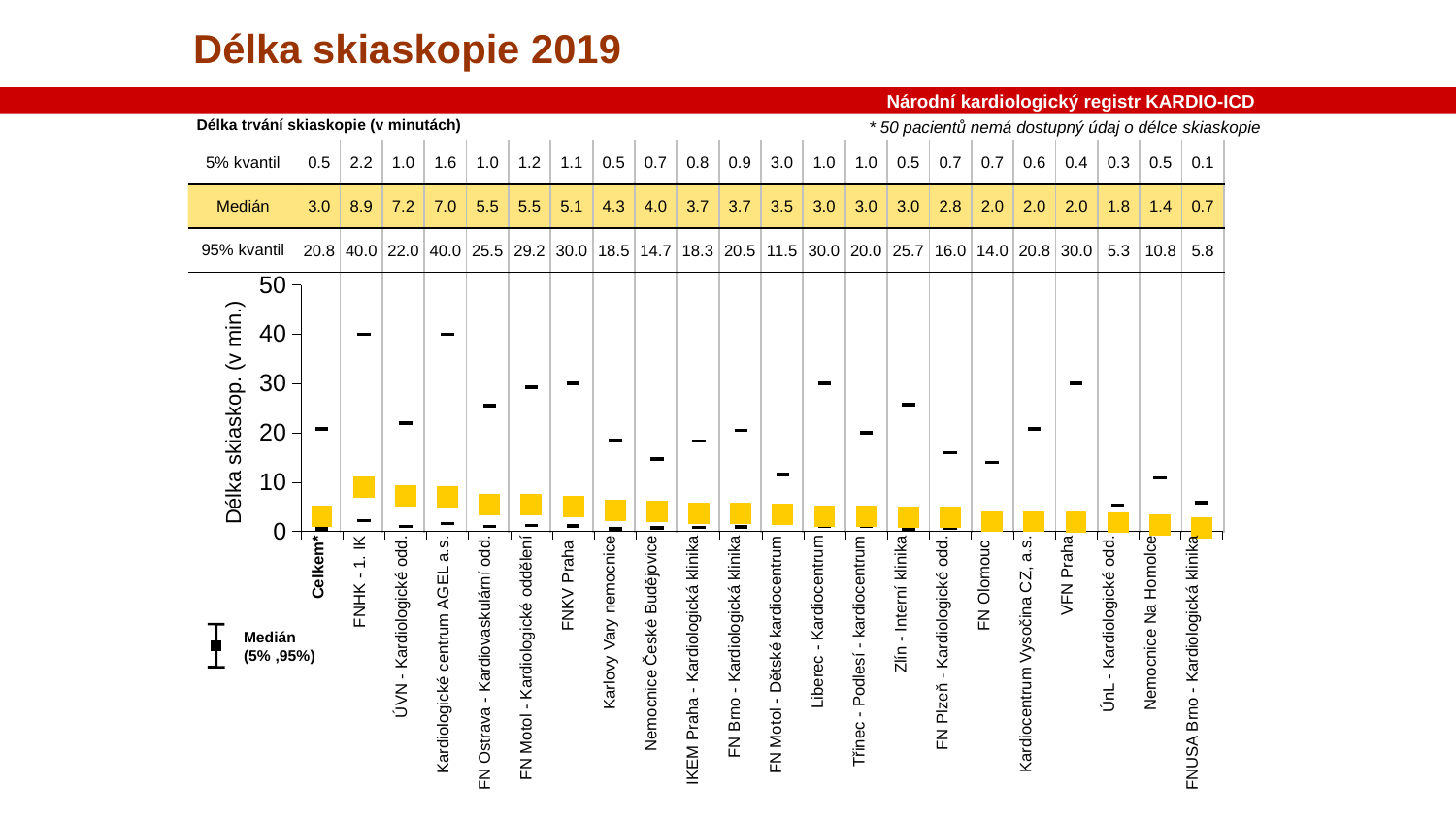
Which centre has the lowest median length of skiascopy? FNUSA Brno - Kardiologická klinika According to the footnote, how many patients have no available data on the length of skiascopy? 50 Which has the larger 95% kvantil value: Liberec - Kardiocentrum or Třinec - Podlesí - kardiocentrum? Liberec - Kardiocentrum How many centres (categories) are shown on the x axis of the chart? 22 Do the median values rise or fall moving from left to right along the x axis? fall What is the median (Medián) length of skiascopy for FNHK - 1. IK? 8.9 What is the 5% kvantil value for FN Motol - Dětské kardiocentrum? 3.0 What is the 95% kvantil value for FNKV Praha? 30.0 What is the median value for Celkem*? 3.0 Which centre has the highest median length of skiascopy? FNHK - 1. IK What is the difference between the median for FNHK - 1. IK and the median for Celkem*? 5.9 What is the title of the y axis of the chart? Délka skiaskop. (v min.)